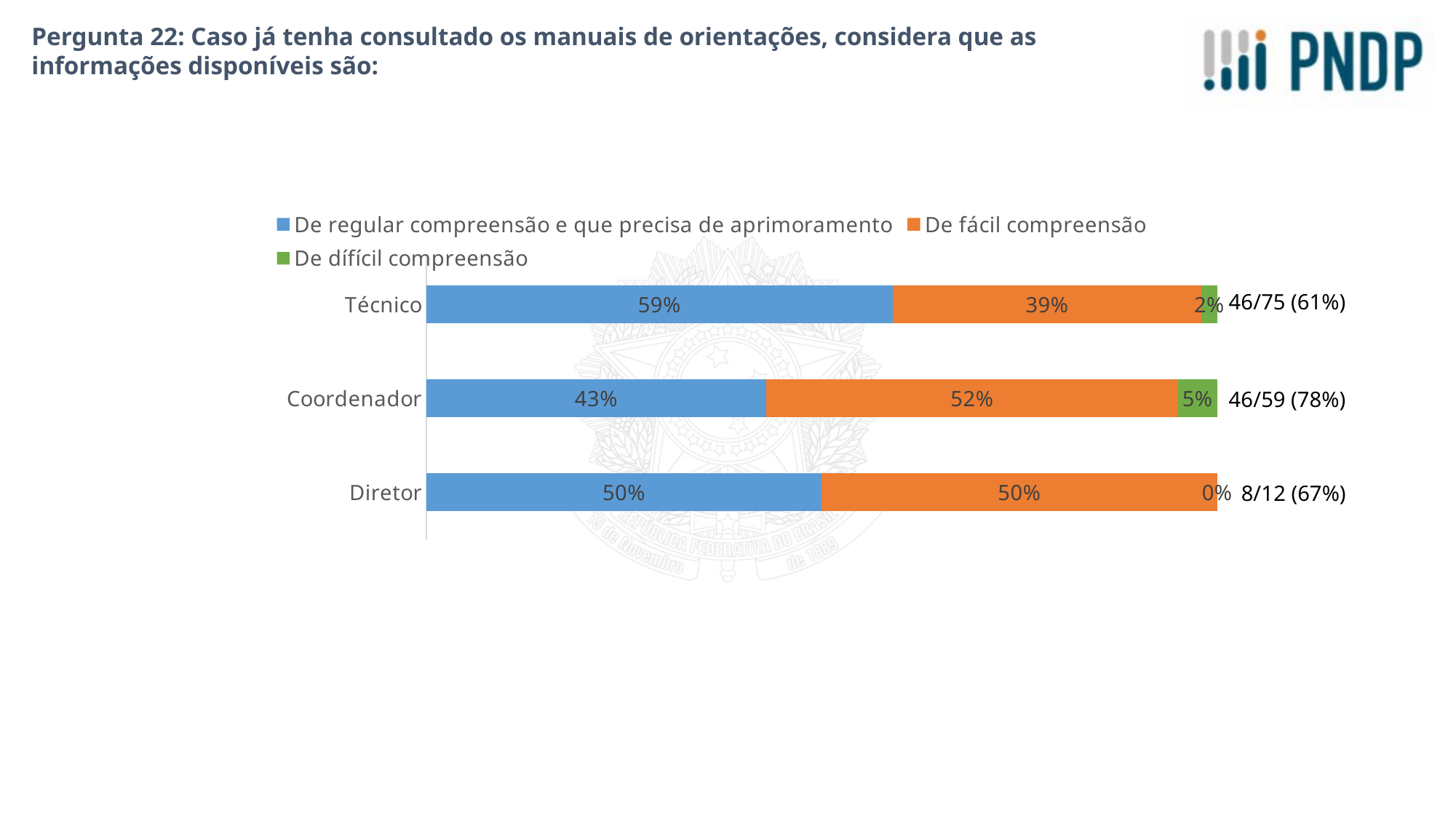
What percentage of Coordenador respondents answered 'De difícil compreensão'? 5% What percentage of Técnico respondents answered 'De regular compreensão e que precisa de aprimoramento'? 59% Which category has the highest share for 'De regular compreensão e que precisa de aprimoramento'? Técnico Is the 'De regular compreensão e que precisa de aprimoramento' share larger for Técnico or for Coordenador? Técnico What percentage of Coordenador respondents answered 'De fácil compreensão'? 52% What is the difference between the 'De fácil compreensão' shares for Coordenador and Técnico? 13% Which category has the lowest share for 'De fácil compreensão'? Técnico How many categories are shown on the y axis? 3 What response count and rate is shown next to the Coordenador bar? 46/59 (78%) What kind of chart is shown on the slide? Stacked bar chart What percentage of Diretor respondents answered 'De difícil compreensão'? 0% How many series does the legend list? 3